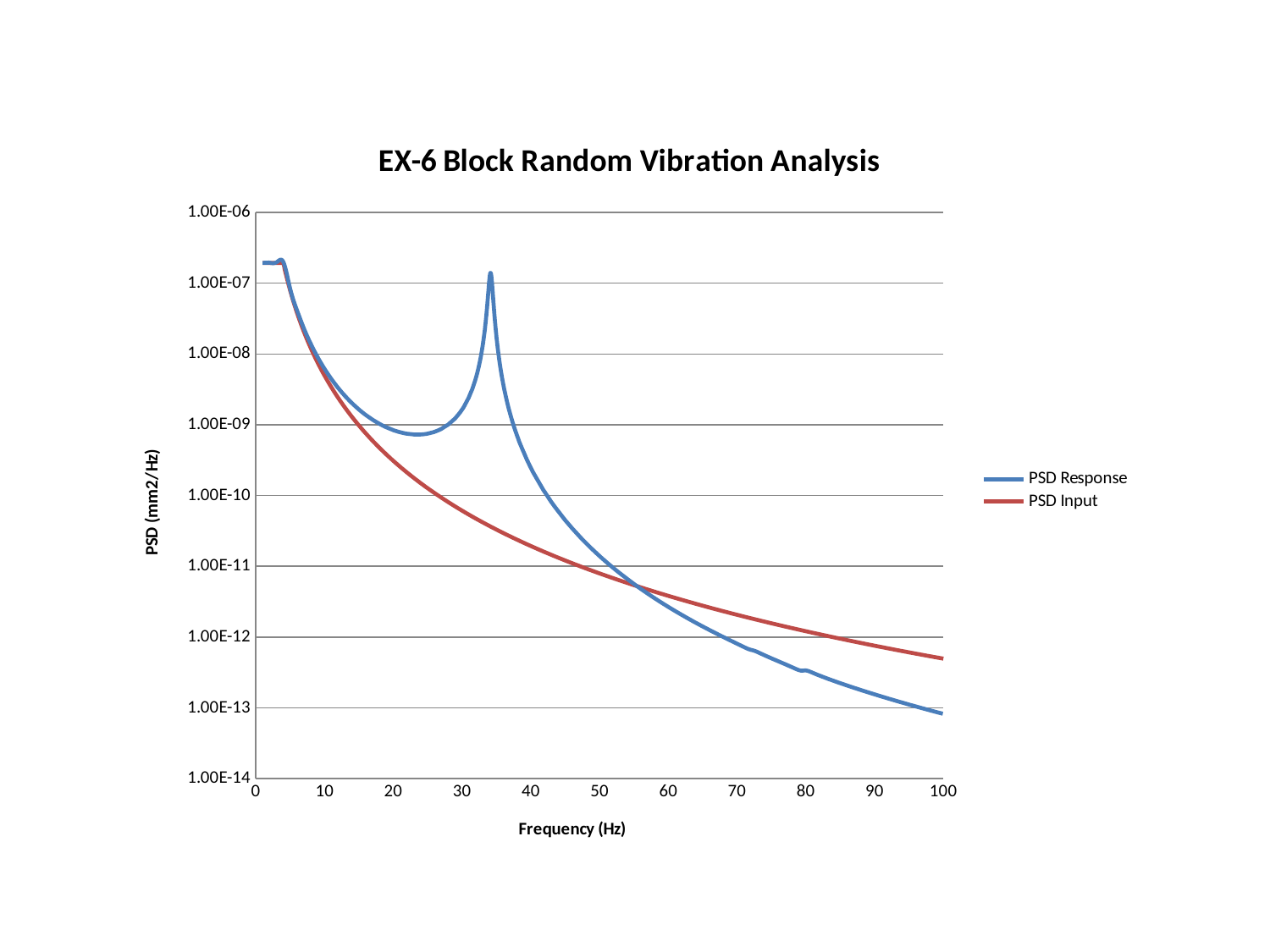
At 30 Hz, which series has the higher value, PSD Response or PSD Input? PSD Response How many series does the legend list? 2 Is the value of PSD Response at 60 Hz greater or less than 1.00E-11? less Does the PSD Input series rise or fall as frequency increases from 10 Hz to 100 Hz? fall Is the value of PSD Input at 100 Hz greater or less than 1.00E-12? less Is the value of PSD Input at 30 Hz greater or less than 1.00E-10? less What kind of chart is shown on the slide? line chart What is the label of the x axis? Frequency (Hz) At 100 Hz, which series has the higher value, PSD Response or PSD Input? PSD Input What is the title of the chart? EX-6 Block Random Vibration Analysis